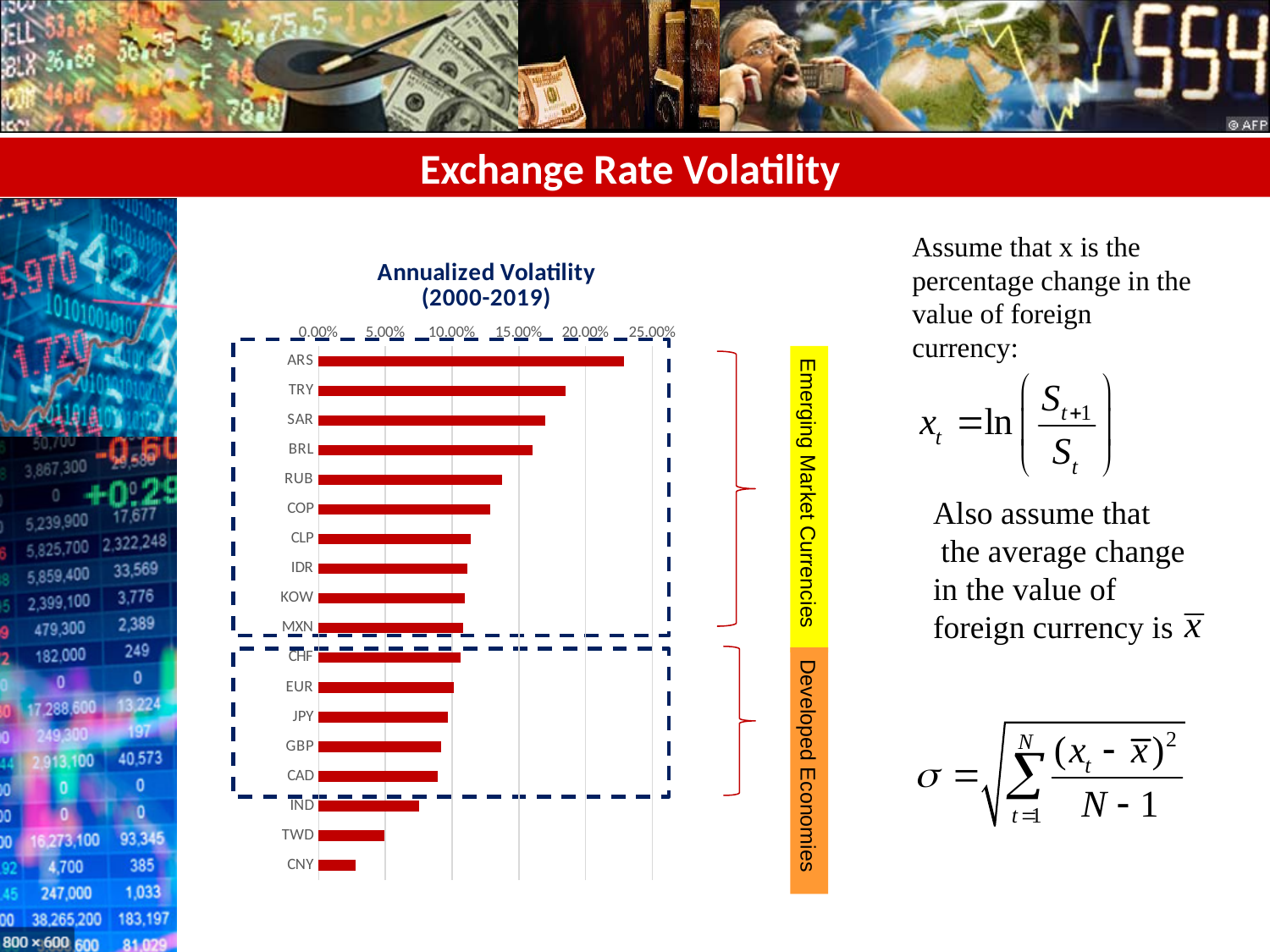
Which has a higher annualized volatility, TWD or CNY? TWD Which currency has the lowest annualized volatility? CNY What is the title of the chart? Annualized Volatility (2000-2019) Which currency has the highest annualized volatility? ARS Is the annualized volatility for TRY greater or less than 15.00%? greater Is the annualized volatility for CNY greater or less than 5.00%? less What type of chart is shown on the slide? bar chart Is the annualized volatility for ARS greater or less than 20.00%? greater Which has a higher annualized volatility, ARS or TRY? ARS How many currencies are plotted in the chart? 18